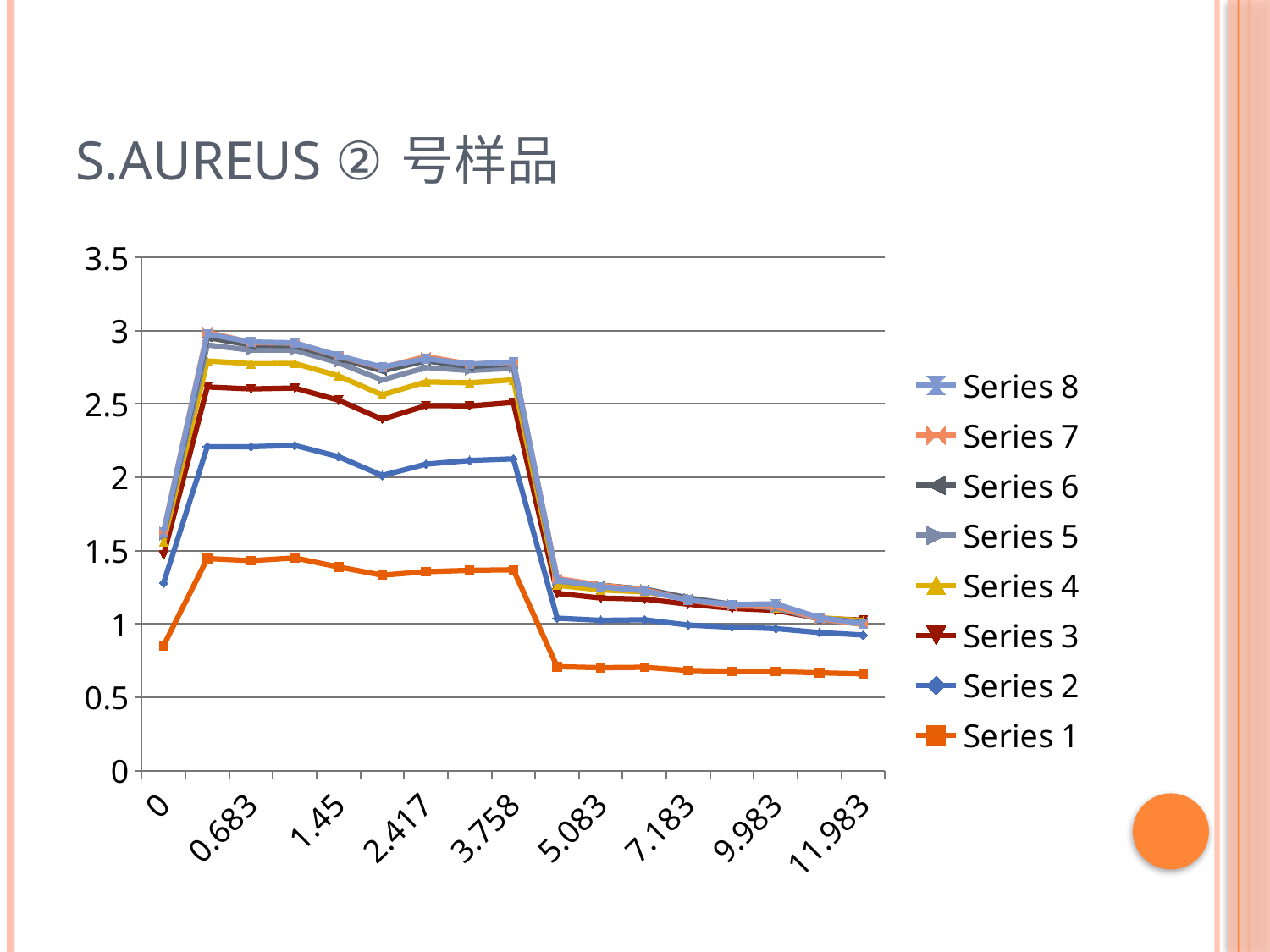
Is the value for Series 2 at x = 11.983 greater or less than 1? less What colour is the line for Series 1 in the legend? Orange What kind of chart is shown on the slide? Line chart Is the value for Series 1 at x = 11.983 greater or less than 0.5? greater Do the values for Series 1 rise or fall from x = 5.083 to x = 11.983? Fall What is the title of the chart? S.AUREUS ② 号样品 How many series does the legend list? 8 Is the value for Series 1 at x = 0.683 greater or less than 1? greater